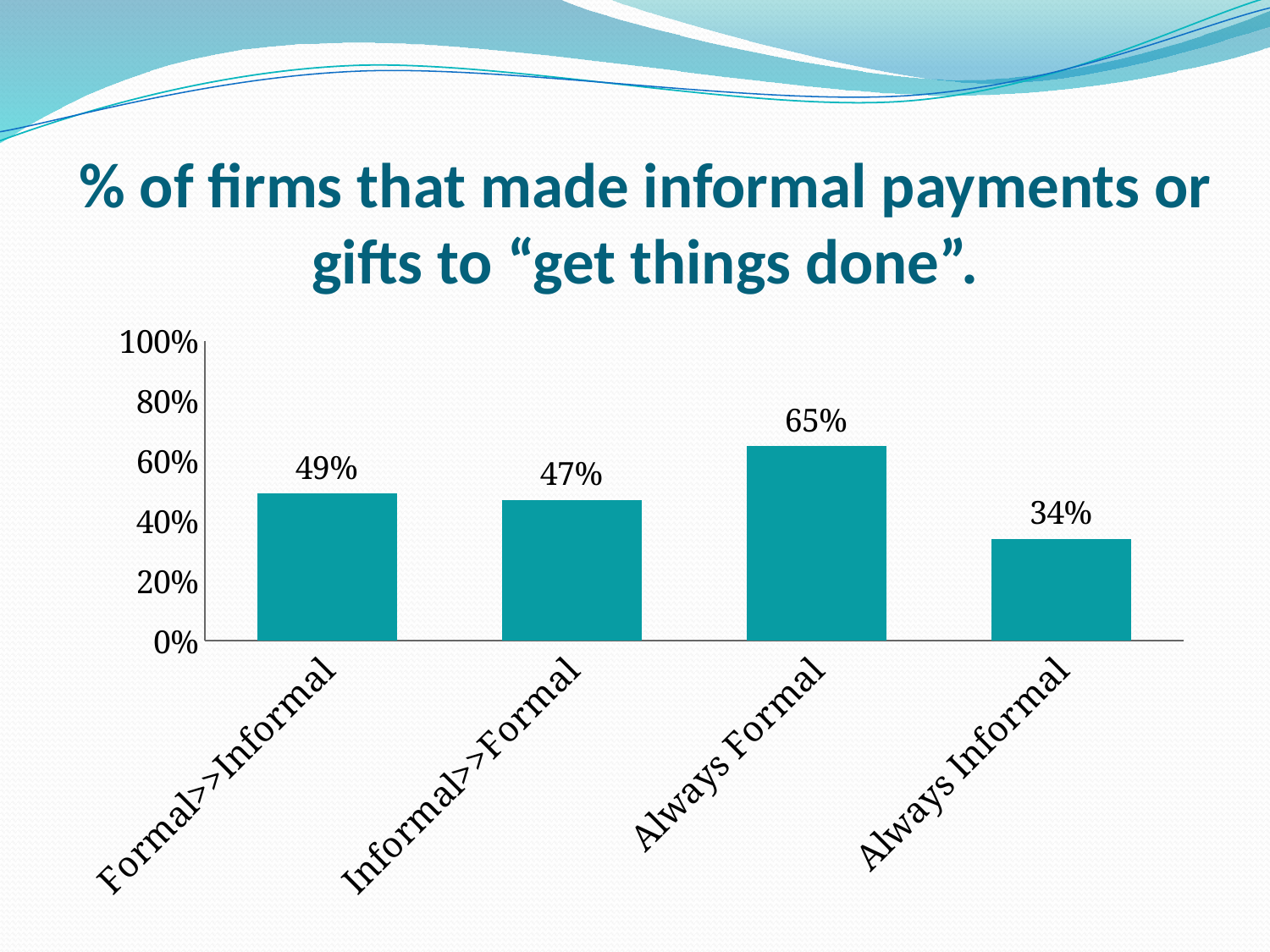
Which category has the lowest value? Always Informal What is the value for Formal>>Informal? 49% Which category has the highest value? Always Formal What is the difference between the values for Formal>>Informal and Informal>>Formal? 2% What is the difference between the values for Always Formal and Always Informal? 31% What kind of chart is shown on the slide? bar chart Is the value for Always Informal greater or less than 40%? less What is the value for Always Formal? 65% What is the value for Always Informal? 34% How many categories are shown on the x axis? 4 What is the value for Informal>>Formal? 47% Which is larger, the value for Always Formal or the value for Formal>>Informal? Always Formal